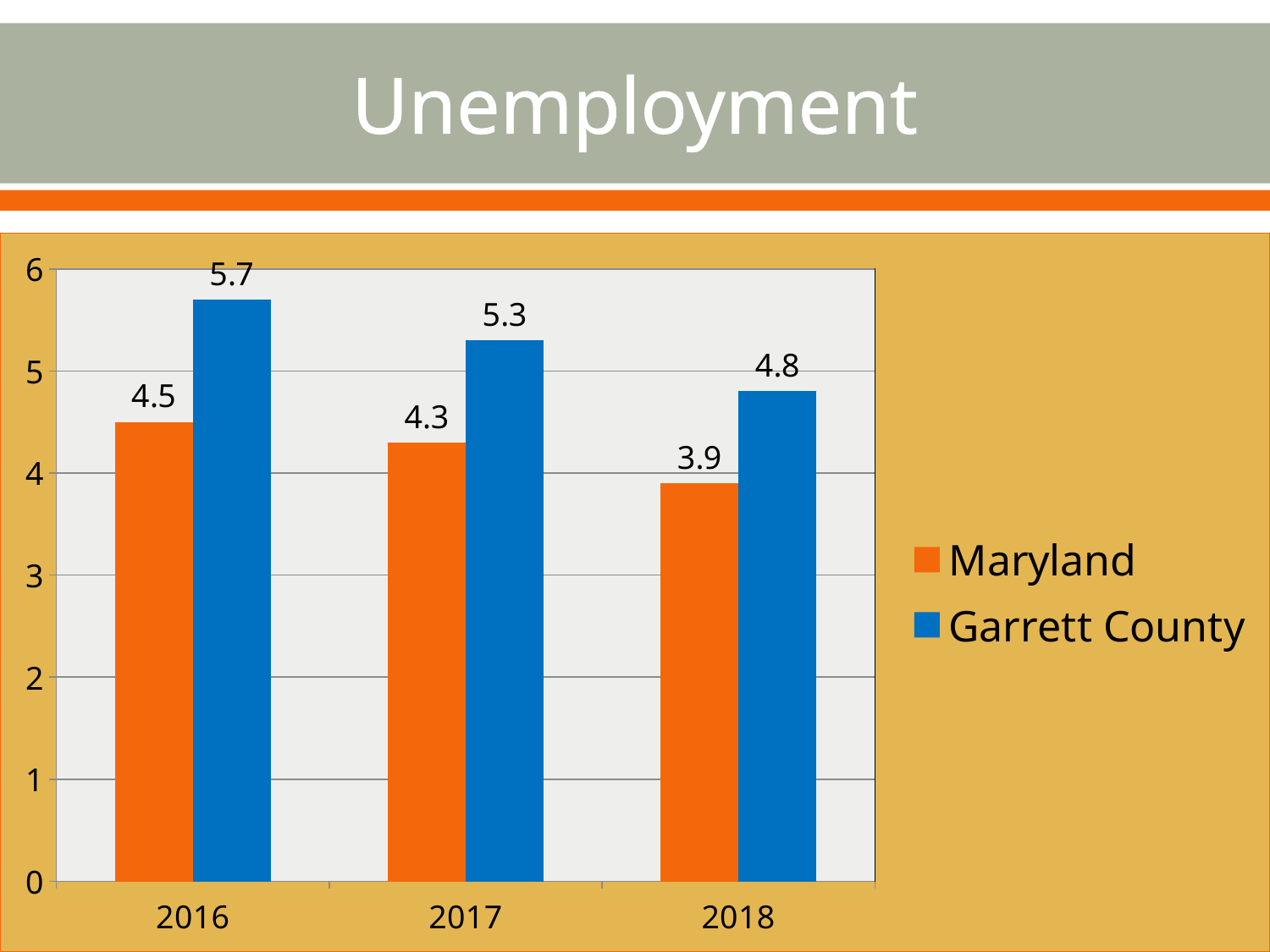
What is the Garrett County value for 2017? 5.3 In which year is the Garrett County value highest? 2016 How many series does the legend list? 2 What is the difference between the Garrett County and Maryland values in 2016? 1.2 What kind of chart is shown on the slide? bar chart Which is larger in 2017, the Maryland value or the Garrett County value? Garrett County What is the Garrett County unemployment value for 2018? 4.8 What is the difference between the Maryland values for 2016 and 2018? 0.6 What is the Maryland unemployment value for 2016? 4.5 In which year is the Maryland value lowest? 2018 How many years are shown on the x axis? 3 Do the Garrett County values rise or fall from 2016 to 2018? fall